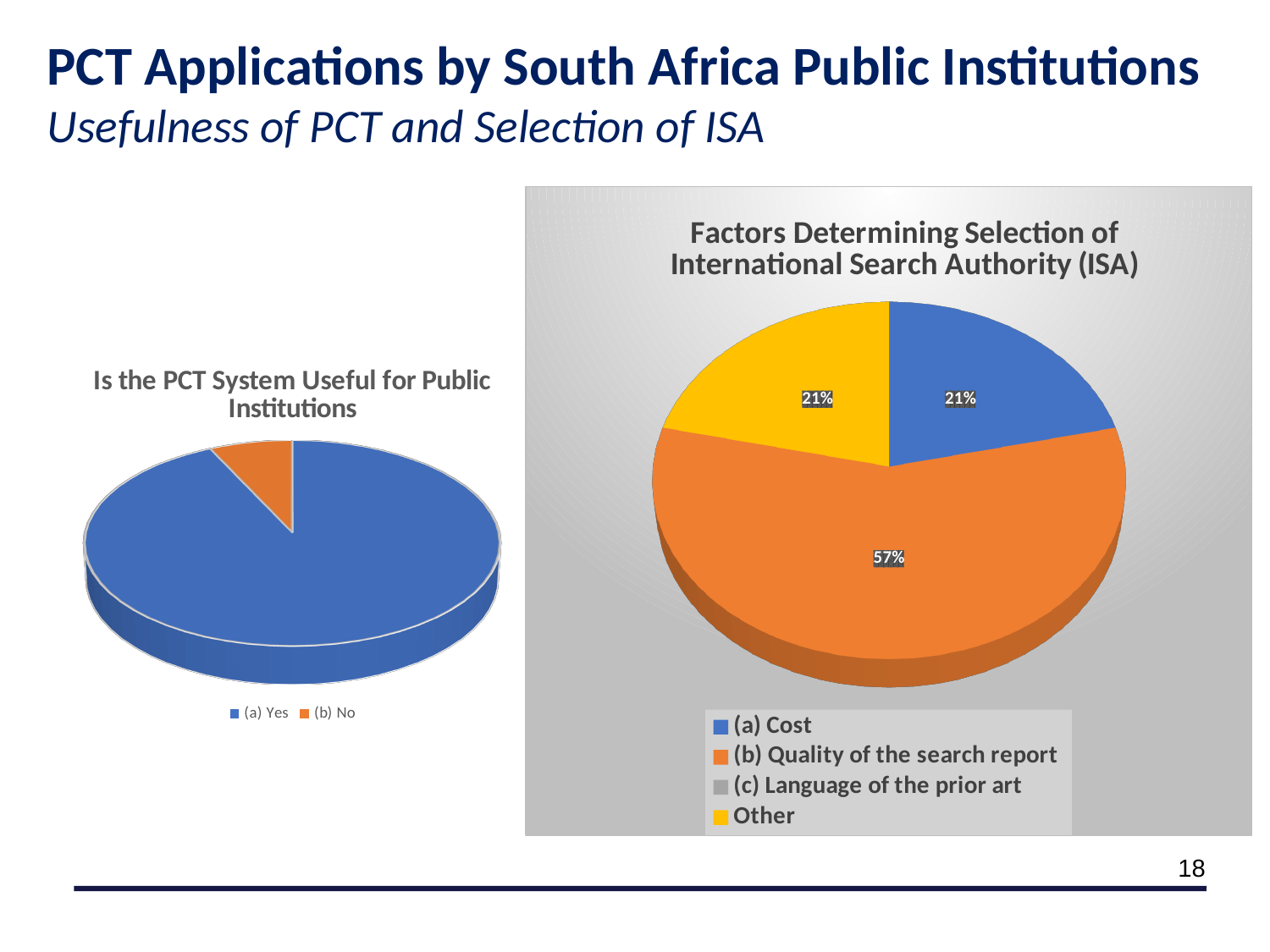
In the chart titled "Factors Determining Selection of International Search Authority (ISA)", what share is labelled for (a) Cost? 21% In the chart titled "Factors Determining Selection of International Search Authority (ISA)", how many percentage points larger is the slice for (b) Quality of the search report than the slice for (a) Cost? 36 percentage points In the chart titled "Is the PCT System Useful for Public Institutions", how many entries does the legend list? 2 In the chart titled "Factors Determining Selection of International Search Authority (ISA)", which factor has the largest slice? (b) Quality of the search report What kind of chart is the chart titled "Is the PCT System Useful for Public Institutions"? Pie chart In the chart titled "Factors Determining Selection of International Search Authority (ISA)", what share is labelled for (b) Quality of the search report? 57% In the chart titled "Factors Determining Selection of International Search Authority (ISA)", what share is labelled for Other? 21% In the chart titled "Is the PCT System Useful for Public Institutions", which is larger: the slice for (a) Yes or the slice for (b) No? (a) Yes In the chart titled "Factors Determining Selection of International Search Authority (ISA)", what colour is the slice for (a) Cost? Blue In the chart titled "Factors Determining Selection of International Search Authority (ISA)", which is larger: the slice for (a) Cost or the slice for (b) Quality of the search report? (b) Quality of the search report In the chart titled "Factors Determining Selection of International Search Authority (ISA)", how many entries does the legend list? 4 What kind of chart is the chart titled "Factors Determining Selection of International Search Authority (ISA)"? Pie chart